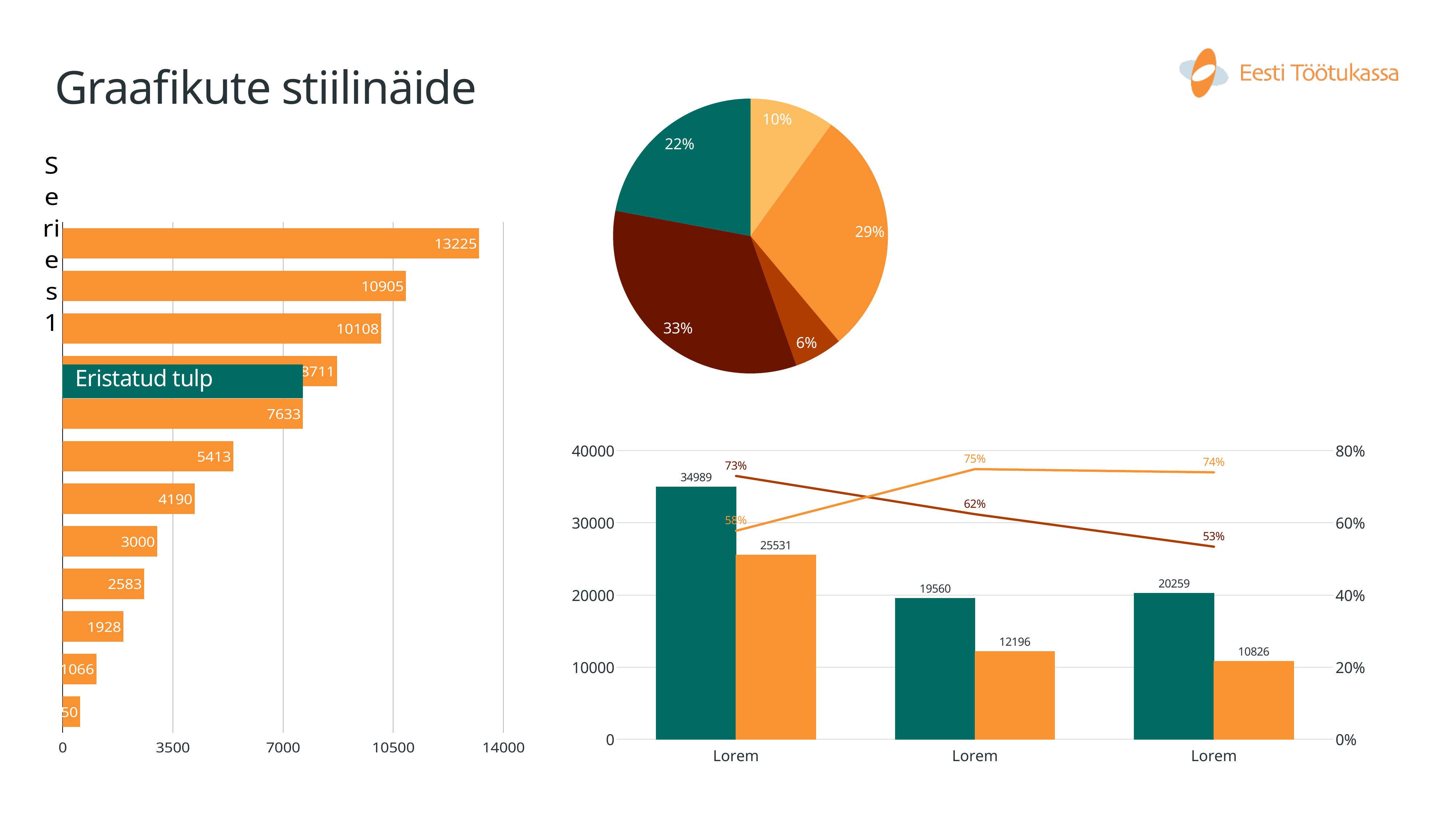
In the combo chart at the bottom right, does the dark orange line rise or fall from the first to the third Lorem group? fall In the pie chart at the top right, what is the share of the smallest slice? 6% In the combo chart at the bottom right, what is the value of the teal bar in the first Lorem group? 34989 In the pie chart at the top right, what is the share of the largest slice? 33% In the combo chart at the bottom right, what is the difference between the teal bar and the orange bar in the first Lorem group? 9458 How many slices does the pie chart at the top right have? 5 How many bars does the horizontal bar chart on the left have? 12 In the horizontal bar chart on the left, what is the value of the bar labelled 7633 minus the bar labelled 5413? 2220 In the combo chart at the bottom right, which is larger: the teal bar in the second Lorem group or the teal bar in the third Lorem group? third Lorem group (20259) In the horizontal bar chart on the left, what text is written on the teal highlighted bar? Eristatud tulp In the horizontal bar chart on the left, what is the value of the longest bar? 13225 In the combo chart at the bottom right, what is the value of the orange bar in the third Lorem group? 10826